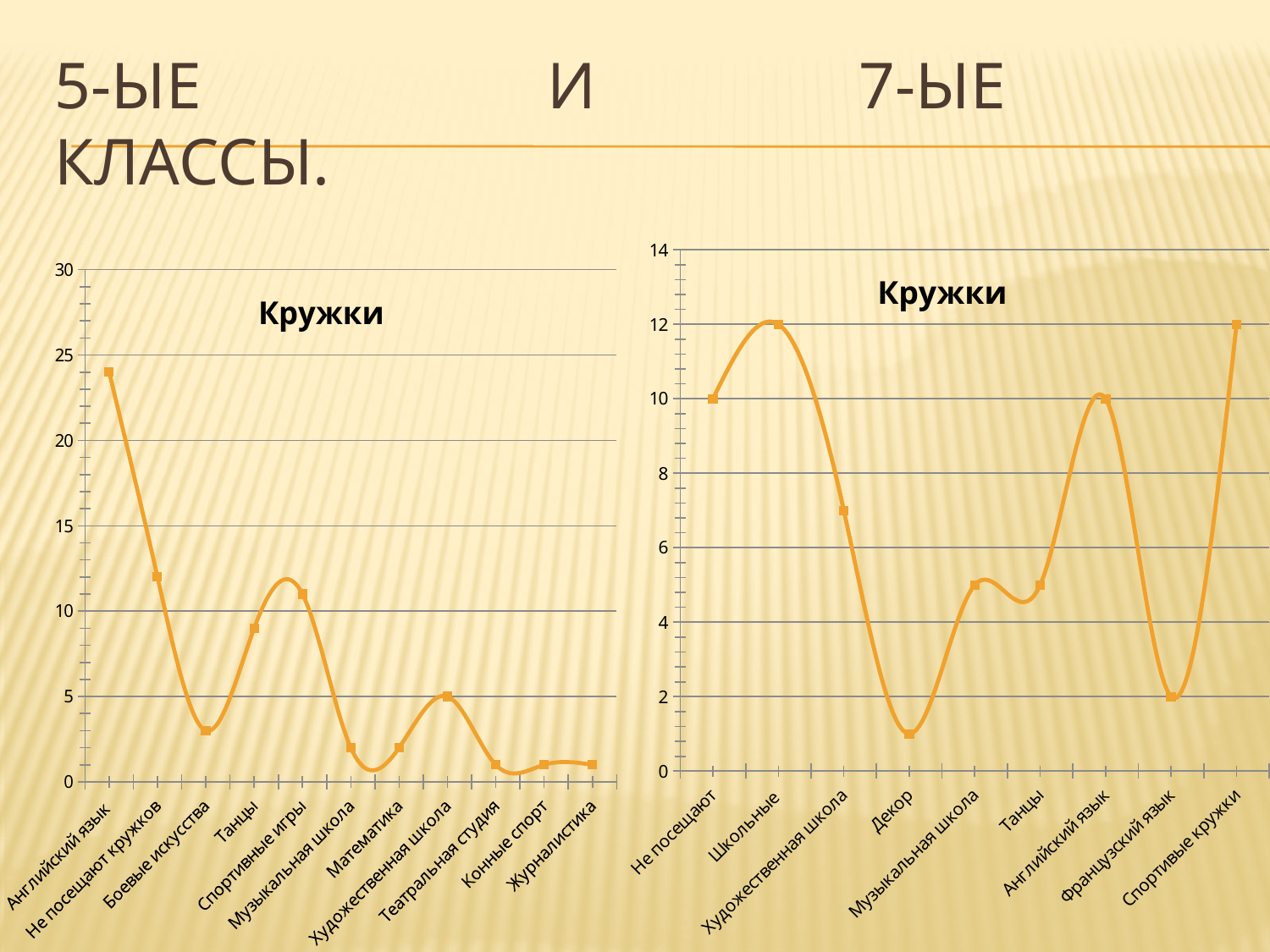
In the left chart, is the value for Английский язык greater or less than 20? greater In the left chart, which is larger, the value for Танцы or the value for Музыкальная школа? Танцы In the left chart, is the value for Боевые искусства greater or less than 5? less What is the title of the right chart? Кружки How many categories are shown on the x axis of the right chart? 9 In the right chart, what is the value for Школьные? 12 What kind of chart is the left chart on the slide? line chart In the right chart, what is the value for Не посещают? 10 In the right chart, what is the value for Французский язык? 2 In the left chart, which category has the highest value? Английский язык In the right chart, what is the difference between the values for Спортивные кружки and Английский язык? 2 How many categories are shown on the x axis of the left chart? 11